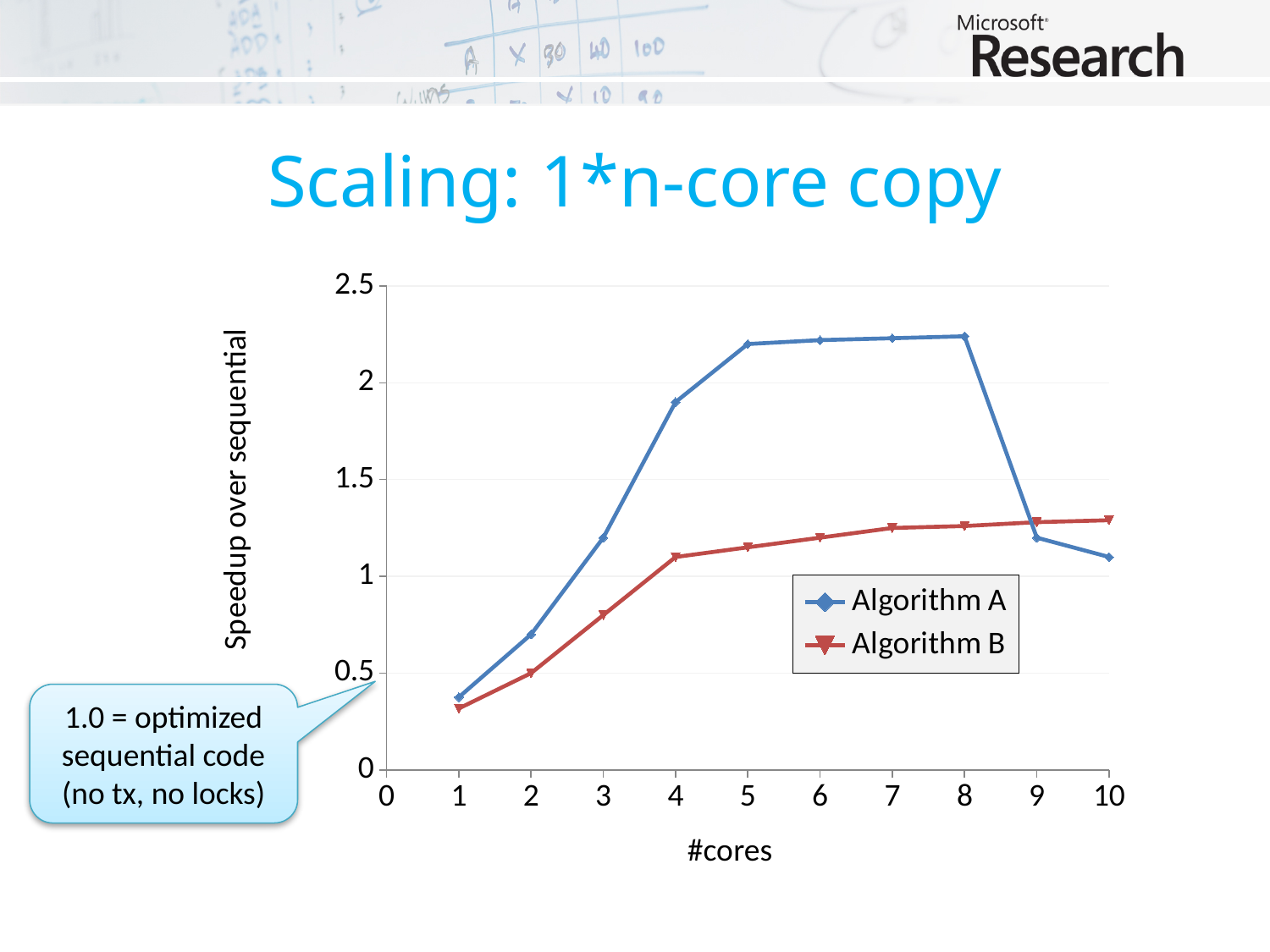
Does the speedup for Algorithm B rise or fall as the number of cores increases? rises At 6 cores, which algorithm has the higher speedup? Algorithm A What kind of chart is shown on the slide? line chart Is the speedup for Algorithm B at 3 cores greater or less than 1? less How many data points are plotted for Algorithm A? 10 Is the speedup for Algorithm A at 5 cores greater or less than 2? greater At 10 cores, which algorithm has the higher speedup? Algorithm B What is the label on the y axis of the chart? Speedup over sequential Is the speedup for Algorithm A at 10 cores greater or less than 1.5? less Which algorithm reaches the highest speedup anywhere on the chart? Algorithm A How many series does the legend list? 2